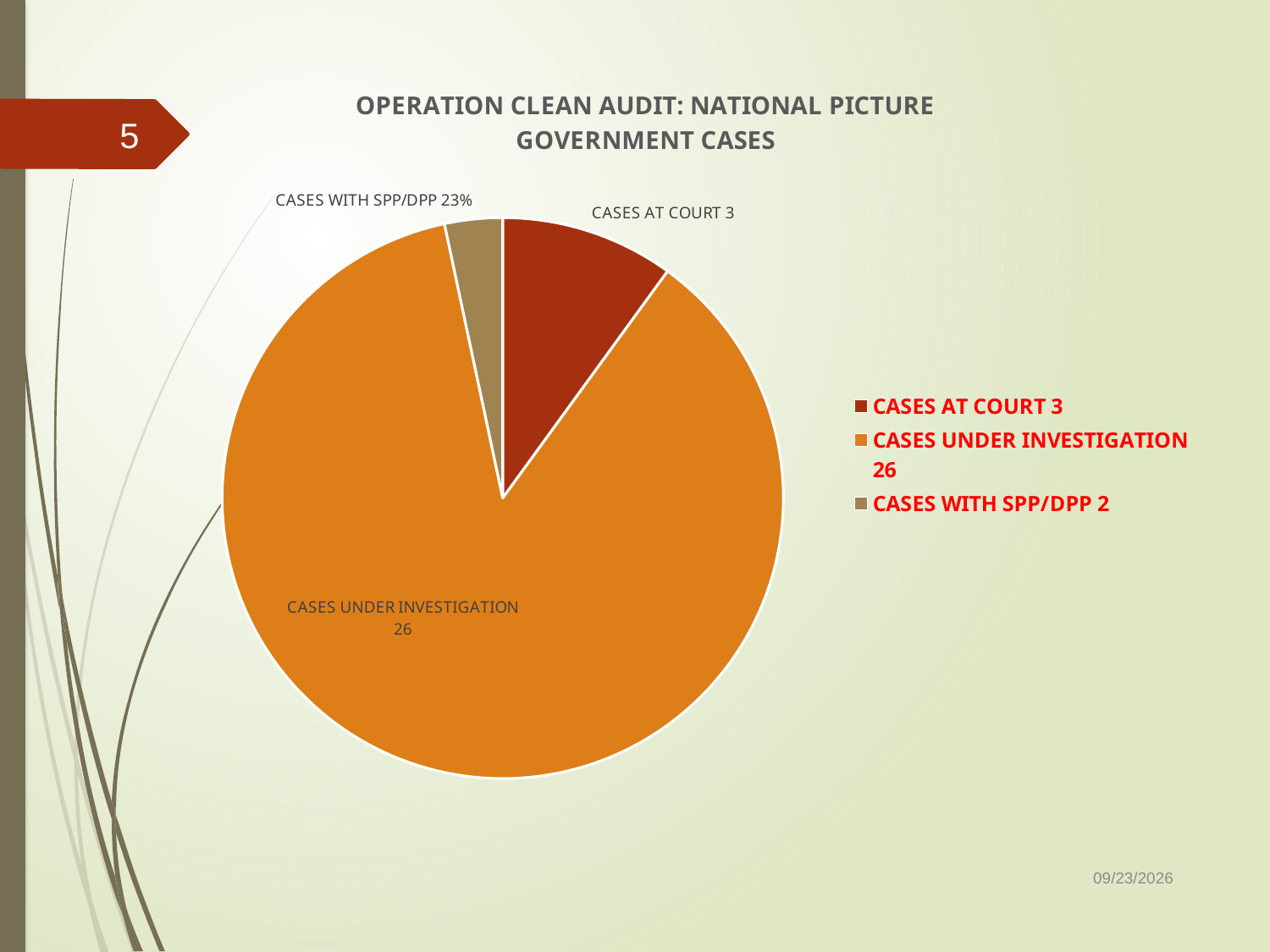
What colour is the slice for cases under investigation? orange Which category has the largest slice of the pie? CASES UNDER INVESTIGATION How many entries does the legend list? 3 What is the difference between the number of cases under investigation and the number of cases at court? 23 What kind of chart is shown on the slide? pie chart How many cases are at court according to the chart? 3 How many cases are under investigation according to the chart? 26 How many categories does the pie chart show? 3 How many cases are with SPP/DPP according to the legend? 2 Which is larger: the number of cases at court or the number of cases with SPP/DPP? CASES AT COURT Which category has the smallest slice of the pie? CASES WITH SPP/DPP What is the title of the chart? OPERATION CLEAN AUDIT: NATIONAL PICTURE GOVERNMENT CASES